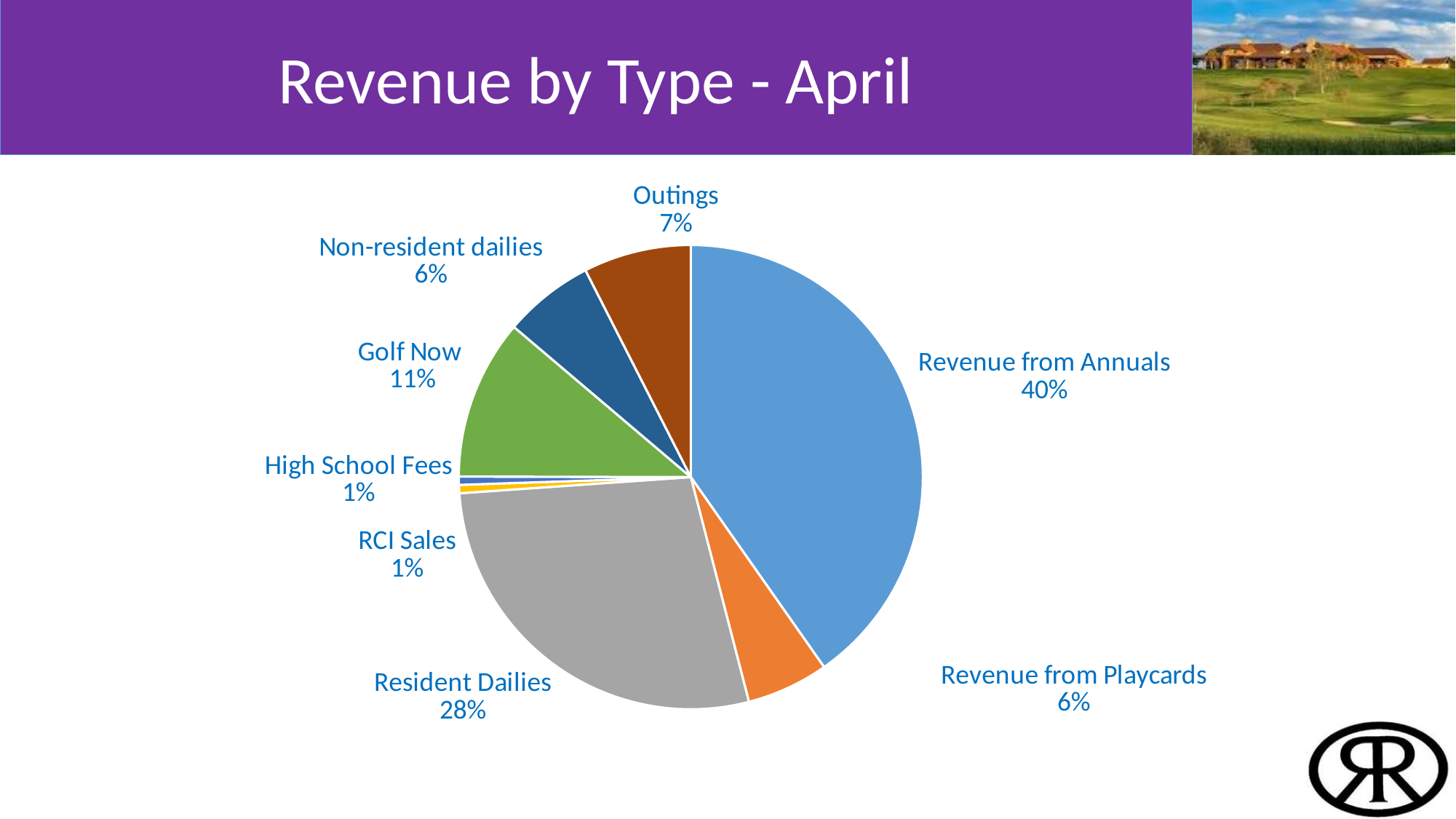
What colour is the Resident Dailies slice? Grey What is the share for Golf Now? 11% What is the share for Revenue from Playcards? 6% Which is larger, Golf Now or Outings? Golf Now What percentage does Outings account for? 7% What share of revenue comes from Revenue from Annuals? 40% What kind of chart is shown on the slide? Pie chart What is the difference in percentage points between Revenue from Annuals and Resident Dailies? 12% What percentage of revenue is Resident Dailies? 28% How many slices does the pie chart have? 8 Which revenue type has the largest share of the pie? Revenue from Annuals What is the title of the chart? Revenue by Type - April